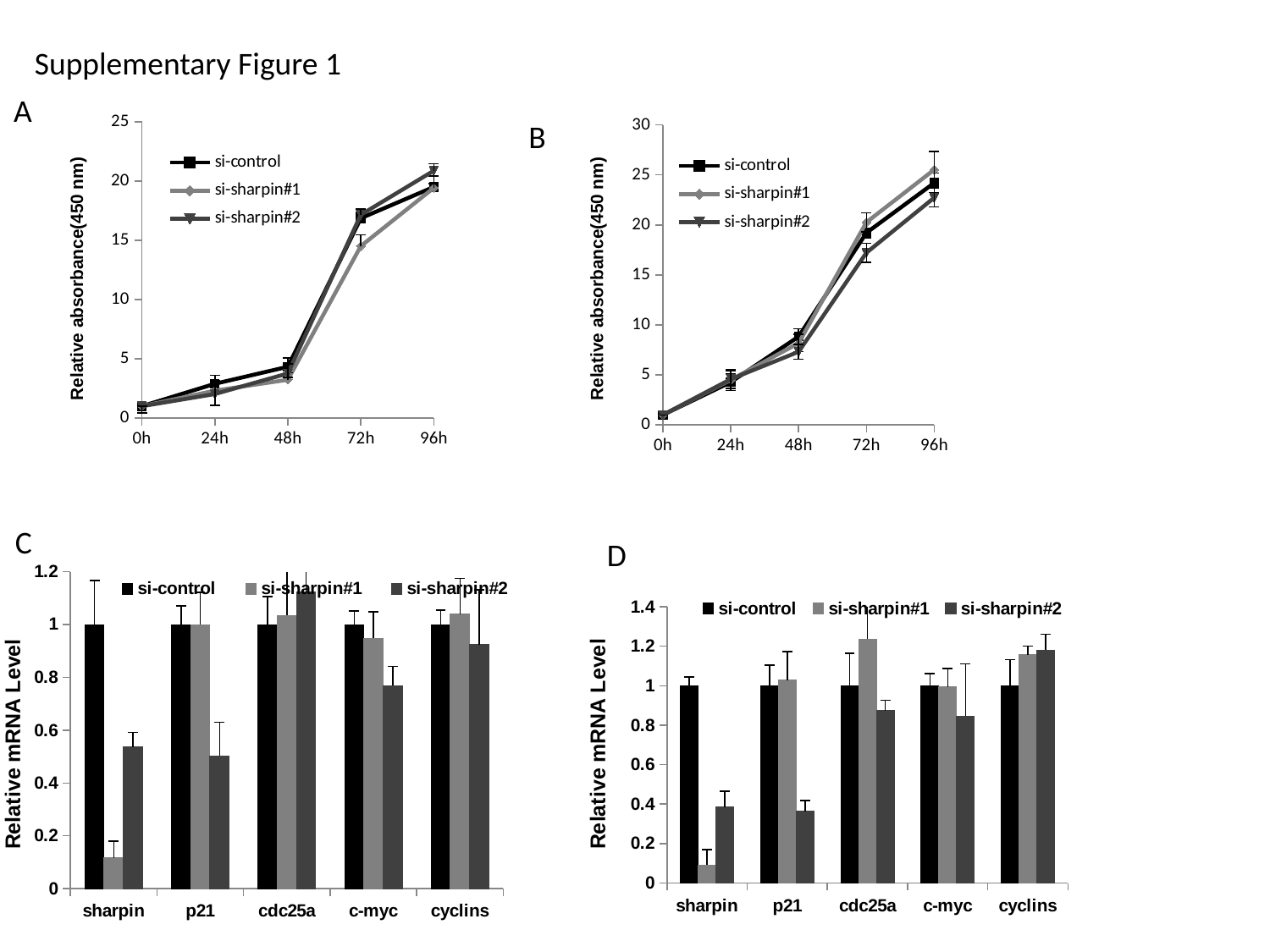
In chart C, how many gene categories are shown on the x axis? 5 In chart D, is the value for si-sharpin#1 for sharpin greater or less than 0.2? less In chart A, do the values for si-control rise or fall from 0h to 96h? rise In chart A, is the value for si-control at 72h greater or less than 15? greater In chart B, is the value for si-sharpin#1 at 96h greater or less than 20? greater In chart A, how many series does the legend list? 3 In chart B, how many time points are plotted along the x axis? 5 In chart C, for p21, which is larger: si-sharpin#1 or si-sharpin#2? si-sharpin#1 In chart C, which series has the lowest bar for sharpin? si-sharpin#1 What kind of chart is chart A? line chart What is the y-axis title of chart D? Relative mRNA Level What kind of chart is chart C? bar chart